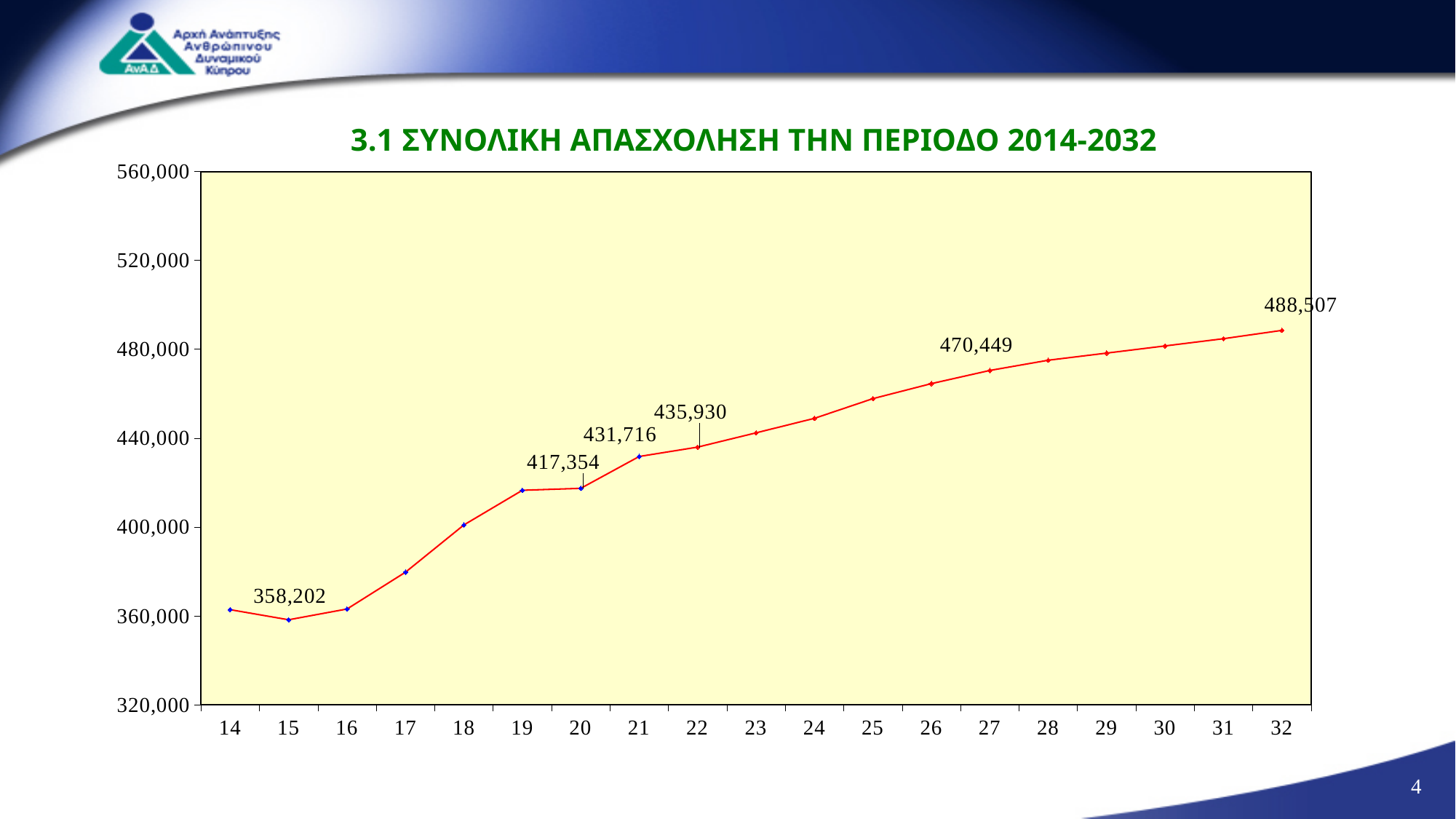
What is the value for year 22 on the chart? 435,930 What is the difference between the values for year 32 and year 15? 130,305 What is the value for year 15 on the chart? 358,202 What is the value for year 27 on the chart? 470,449 How many years are plotted on the x axis? 19 What kind of chart is shown on the slide? line chart Is the value for year 24 greater or less than 440,000? greater What is the value for year 32 on the chart? 488,507 Which year has the lowest value on the chart? 15 What is the value for year 21 on the chart? 431,716 What is the value for year 20 on the chart? 417,354 Which year has the highest value on the chart? 32